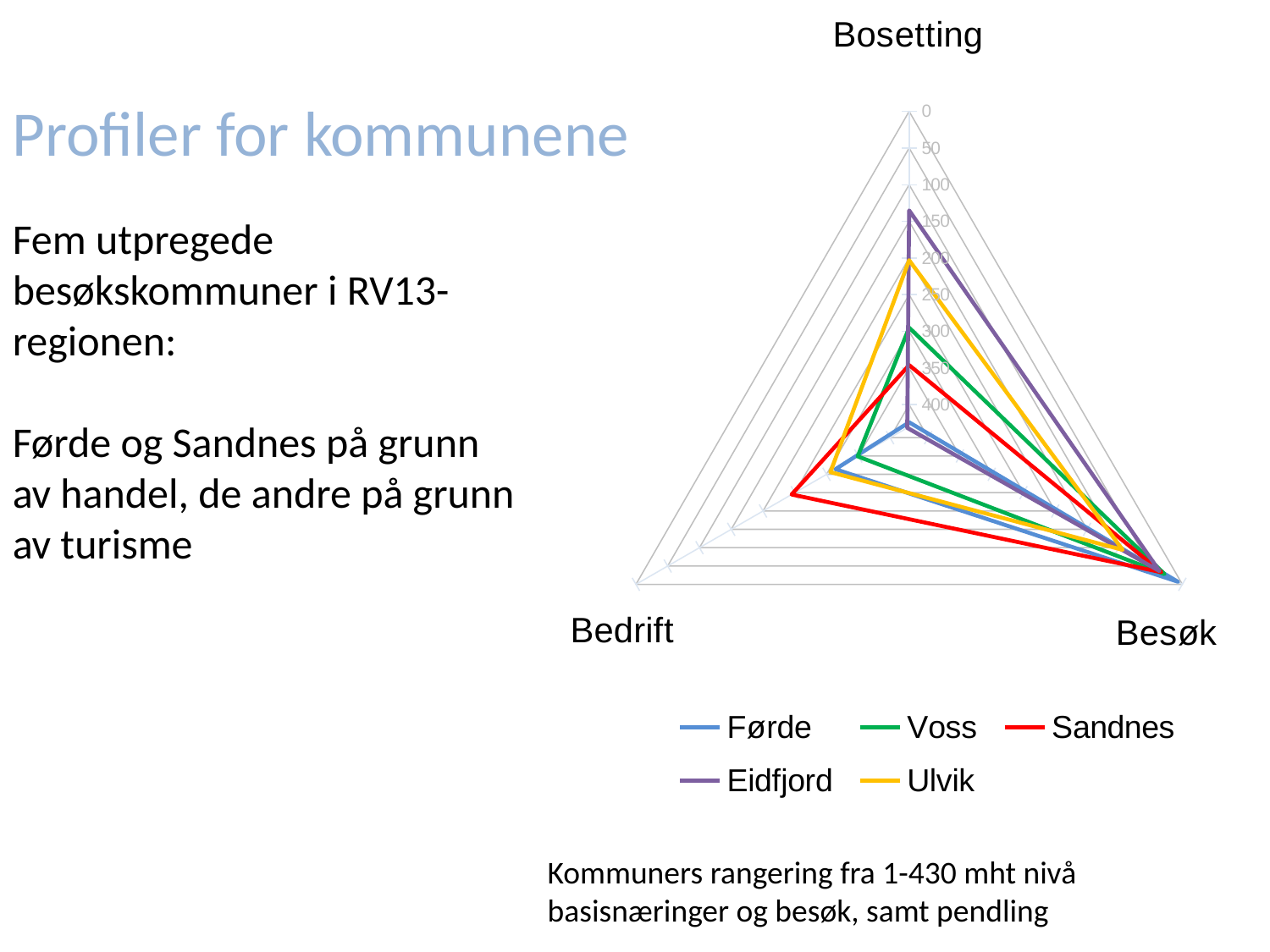
Is the value for Eidfjord on the Bosetting axis larger or smaller than the value for Voss on the same axis? smaller Which series has the smallest value on the Bosetting axis? Eidfjord How many series does the legend list? 5 Is the value for Sandnes on the Bedrift axis greater or less than 150? greater Is the value for Sandnes on the Bedrift axis greater or less than 300? less What kind of chart is shown on the slide? radar chart Is the value for Eidfjord on the Bosetting axis greater or less than 200? less How many axes (categories) does the radar chart have? 3 What are the three category labels on the radar chart? Bosetting, Bedrift, Besøk Which series is drawn in red in the legend? Sandnes